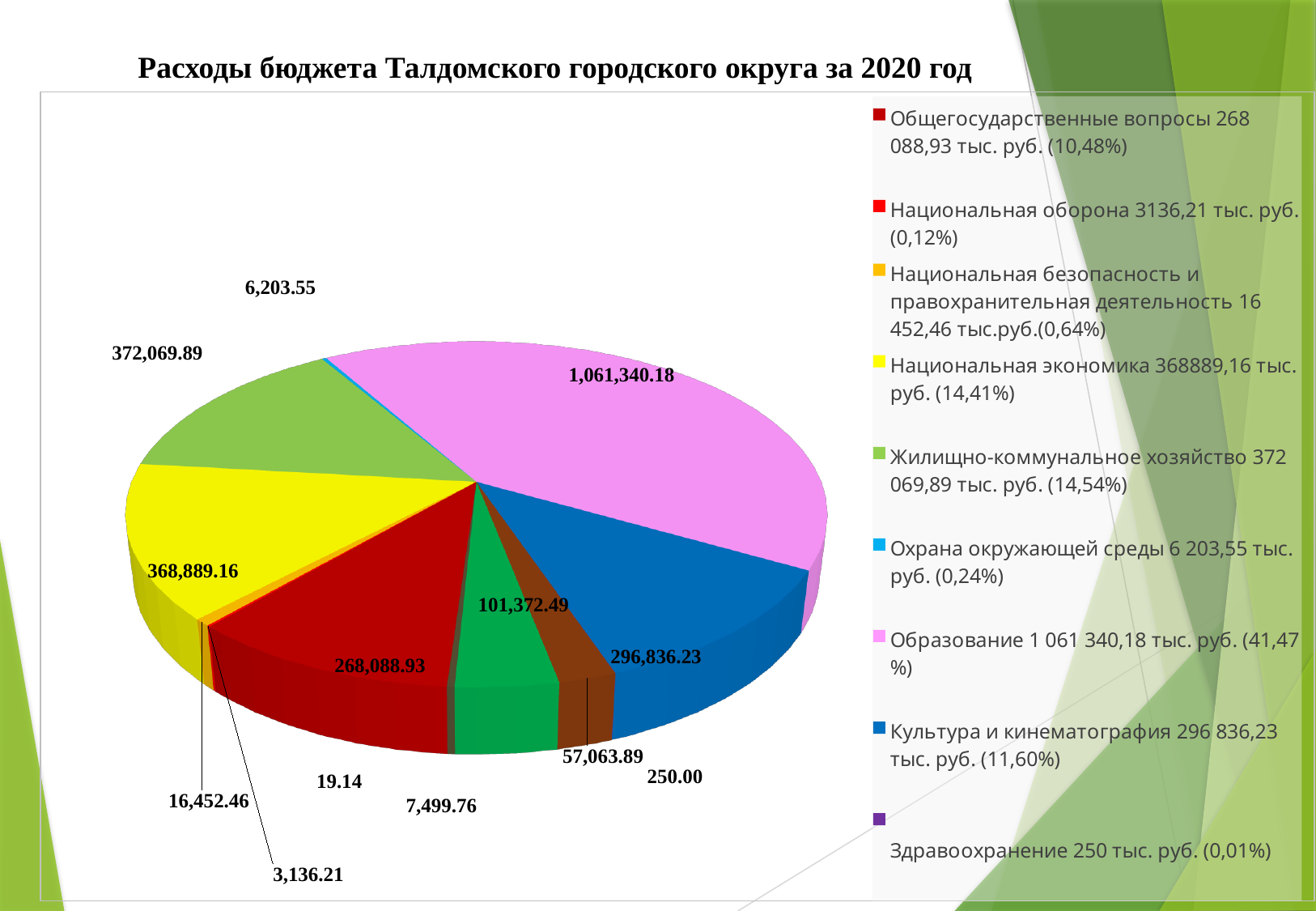
What is the difference between the values for Жилищно-коммунальное хозяйство and Национальная экономика? 3,180.73 What value is shown for Жилищно-коммунальное хозяйство? 372,069.89 What is the smallest data label value shown on the pie chart? 19.14 Which category has the largest slice of the pie? Образование What share of the pie does Образование account for, according to the legend? 41,47 % What is the title of the chart? Расходы бюджета Талдомского городского округа за 2020 год What value is shown for Образование? 1,061,340.18 Which is larger: the value for Культура и кинематография or the value for Общегосударственные вопросы? Культура и кинематография What share of the pie does Национальная экономика account for, according to the legend? 14,41% What type of chart is shown on the slide? pie chart What value is shown for Национальная оборона? 3,136.21 What value is shown for Культура и кинематография? 296,836.23